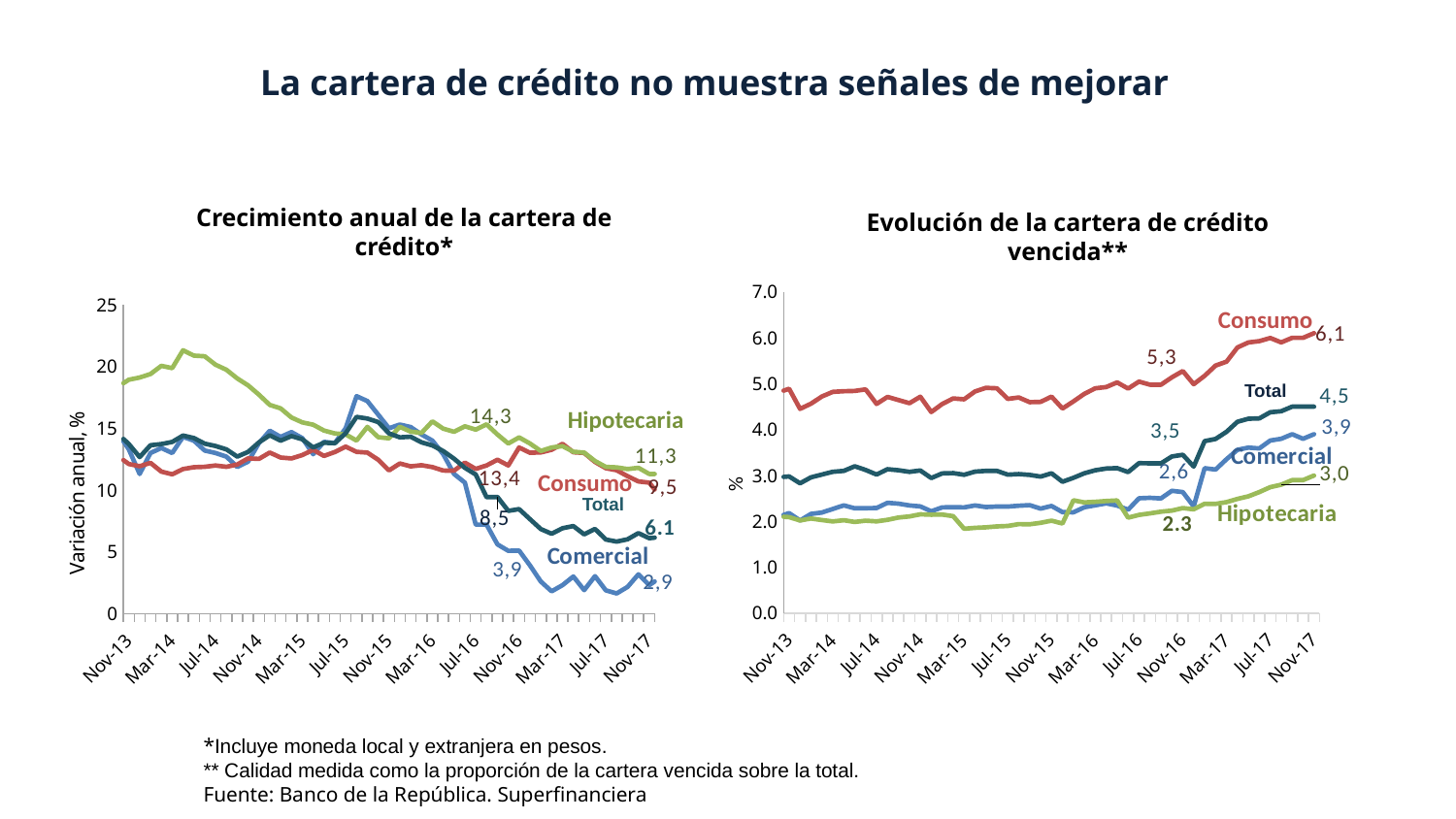
What type of chart is 'Evolución de la cartera de crédito vencida**'? line chart In the chart 'Crecimiento anual de la cartera de crédito*', what is the final value labelled for Total? 6.1 In the chart 'Crecimiento anual de la cartera de crédito*', what is the final value labelled for Comercial? 2,9 In the chart 'Evolución de la cartera de crédito vencida**', what is the final value labelled for Consumo? 6,1 In the chart 'Crecimiento anual de la cartera de crédito*', what is the difference between the final values of Hipotecaria (11,3) and Consumo (9,5)? 1,8 In the chart 'Evolución de la cartera de crédito vencida**', what is the difference between the final values of Total (4,5) and Comercial (3,9)? 0,6 In the chart 'Crecimiento anual de la cartera de crédito*', does the Comercial series rise or fall from Nov-15 to Nov-17? fall In the chart 'Crecimiento anual de la cartera de crédito*', which series has the lowest value at the end of the period? Comercial In the chart 'Evolución de la cartera de crédito vencida**', is the final value for Consumo greater or less than 5.0? greater In the chart 'Evolución de la cartera de crédito vencida**', what is the final value labelled for Hipotecaria? 3,0 In the chart 'Crecimiento anual de la cartera de crédito*', what is the final value labelled for Hipotecaria at Nov-17? 11,3 In the chart 'Evolución de la cartera de crédito vencida**', which series has the highest value at the end of the period? Consumo